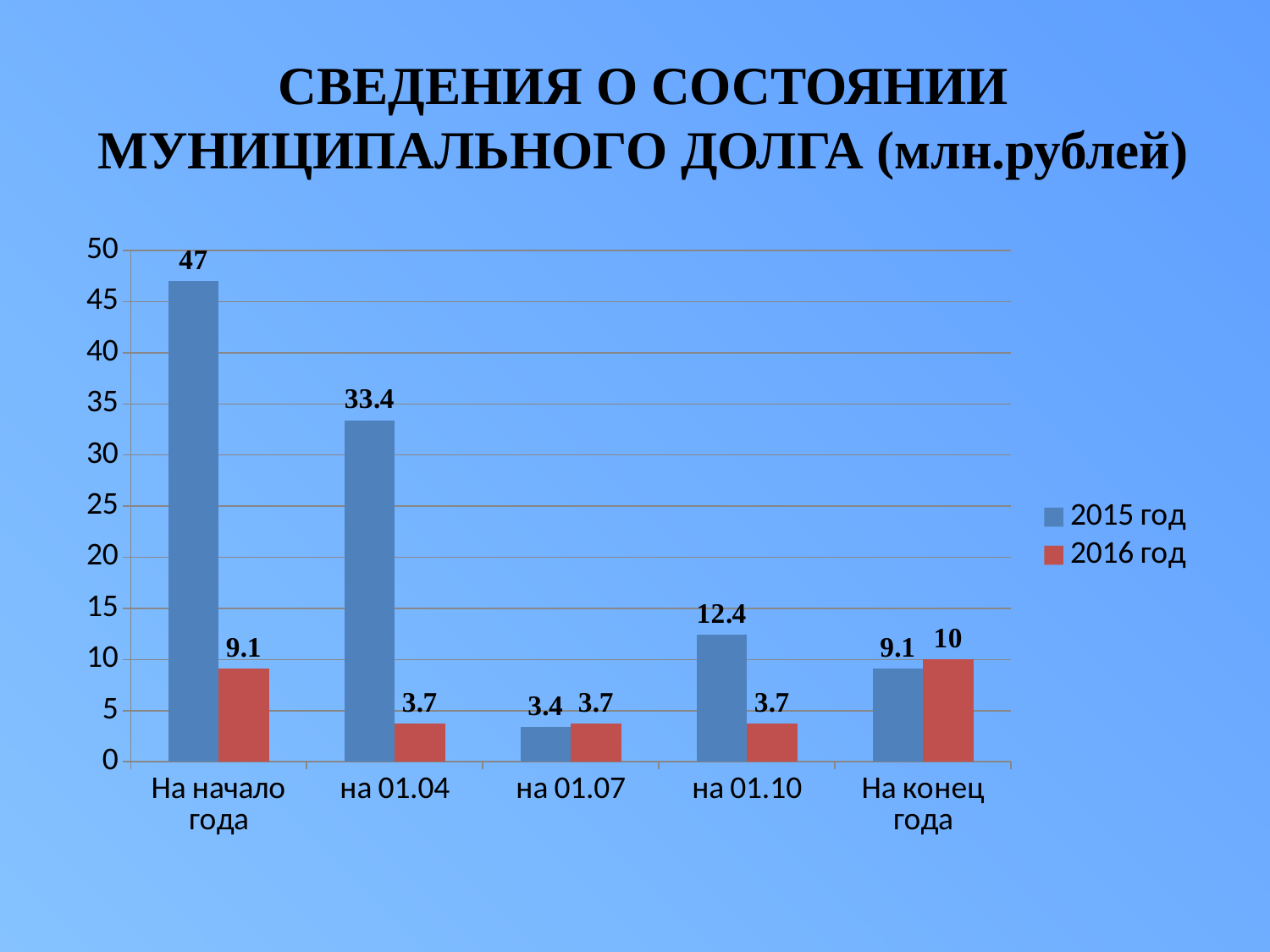
What is the difference between the 2015 год and 2016 год values at На начало года? 37.9 What is the value for 2015 год at на 01.10? 12.4 What is the value for 2016 год at на 01.04? 3.7 What is the value for 2016 год at На конец года? 10 How many series does the legend list? 2 Which category has the highest value for 2016 год? На конец года What kind of chart is shown on the slide? Bar chart Which is larger at На конец года: 2015 год or 2016 год? 2016 год Which category has the lowest value for 2015 год? на 01.07 How many categories are shown on the x axis? 5 Which category has the highest value for 2015 год? На начало года What is the value for 2015 год at На начало года? 47